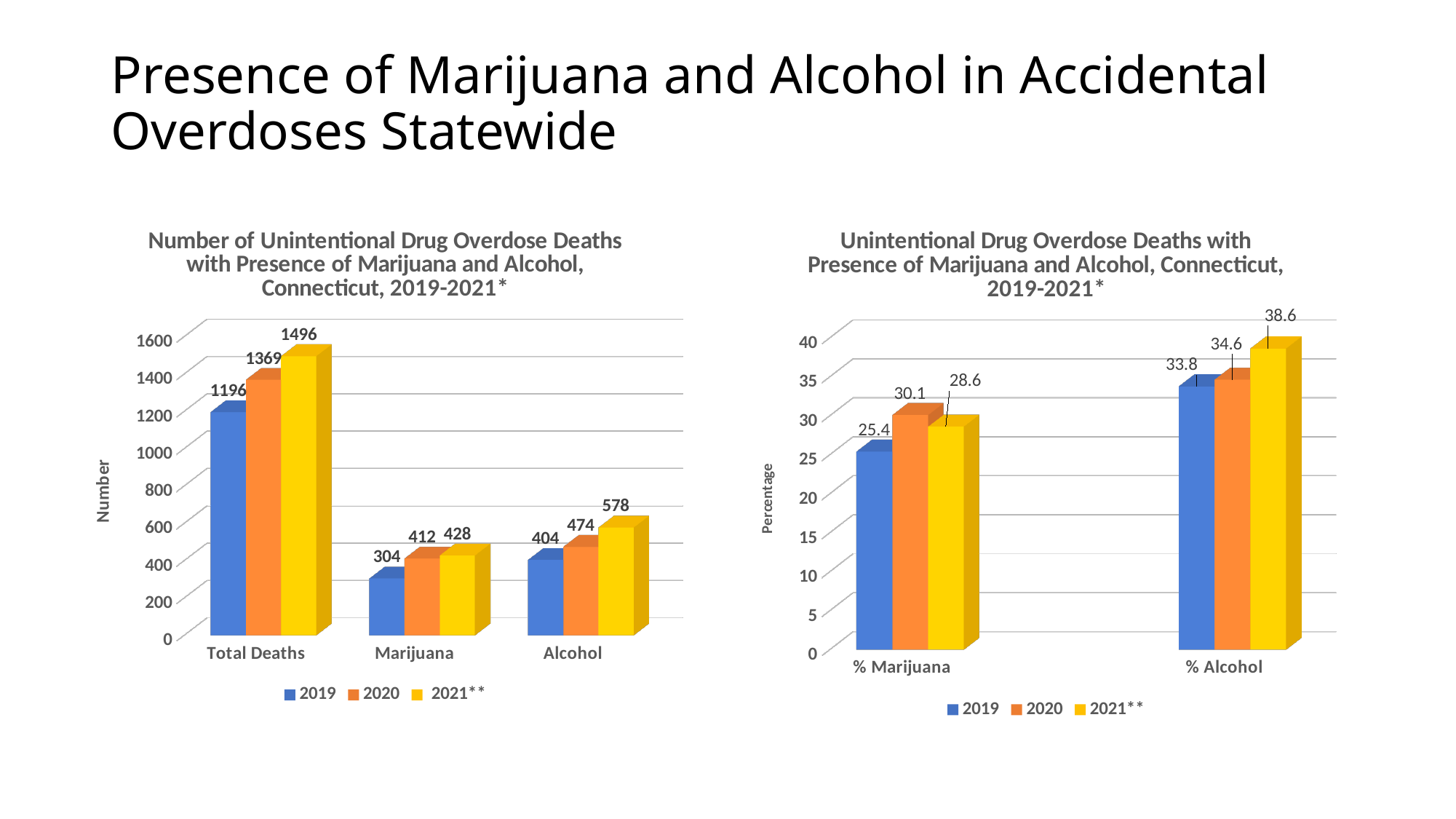
In the left chart (Number of Unintentional Drug Overdose Deaths), what is the value for Alcohol in 2020? 474 In the left chart (Number of Unintentional Drug Overdose Deaths), what is the difference between Alcohol in 2021** and Alcohol in 2019? 174 In the left chart (Number of Unintentional Drug Overdose Deaths), what is the value for Total Deaths in 2021**? 1496 In the right chart (Unintentional Drug Overdose Deaths with Presence of Marijuana and Alcohol), which year has the highest value for % Marijuana? 2020 In the right chart (Unintentional Drug Overdose Deaths with Presence of Marijuana and Alcohol), what is the value for % Alcohol in 2021**? 38.6 In the left chart (Number of Unintentional Drug Overdose Deaths), do the Marijuana values rise or fall from 2019 to 2021**? rise In the right chart (Unintentional Drug Overdose Deaths with Presence of Marijuana and Alcohol), which is larger: % Alcohol in 2019 or % Marijuana in 2020? % Alcohol in 2019 In the left chart (Number of Unintentional Drug Overdose Deaths), how many categories are shown on the x axis? 3 How many series does the legend of the right chart (Unintentional Drug Overdose Deaths with Presence of Marijuana and Alcohol) list? 3 In the left chart (Number of Unintentional Drug Overdose Deaths), which year has the lowest value for Total Deaths? 2019 In the left chart (Number of Unintentional Drug Overdose Deaths), what is the value for Marijuana in 2019? 304 In the right chart (Unintentional Drug Overdose Deaths with Presence of Marijuana and Alcohol), what is the value for % Marijuana in 2020? 30.1